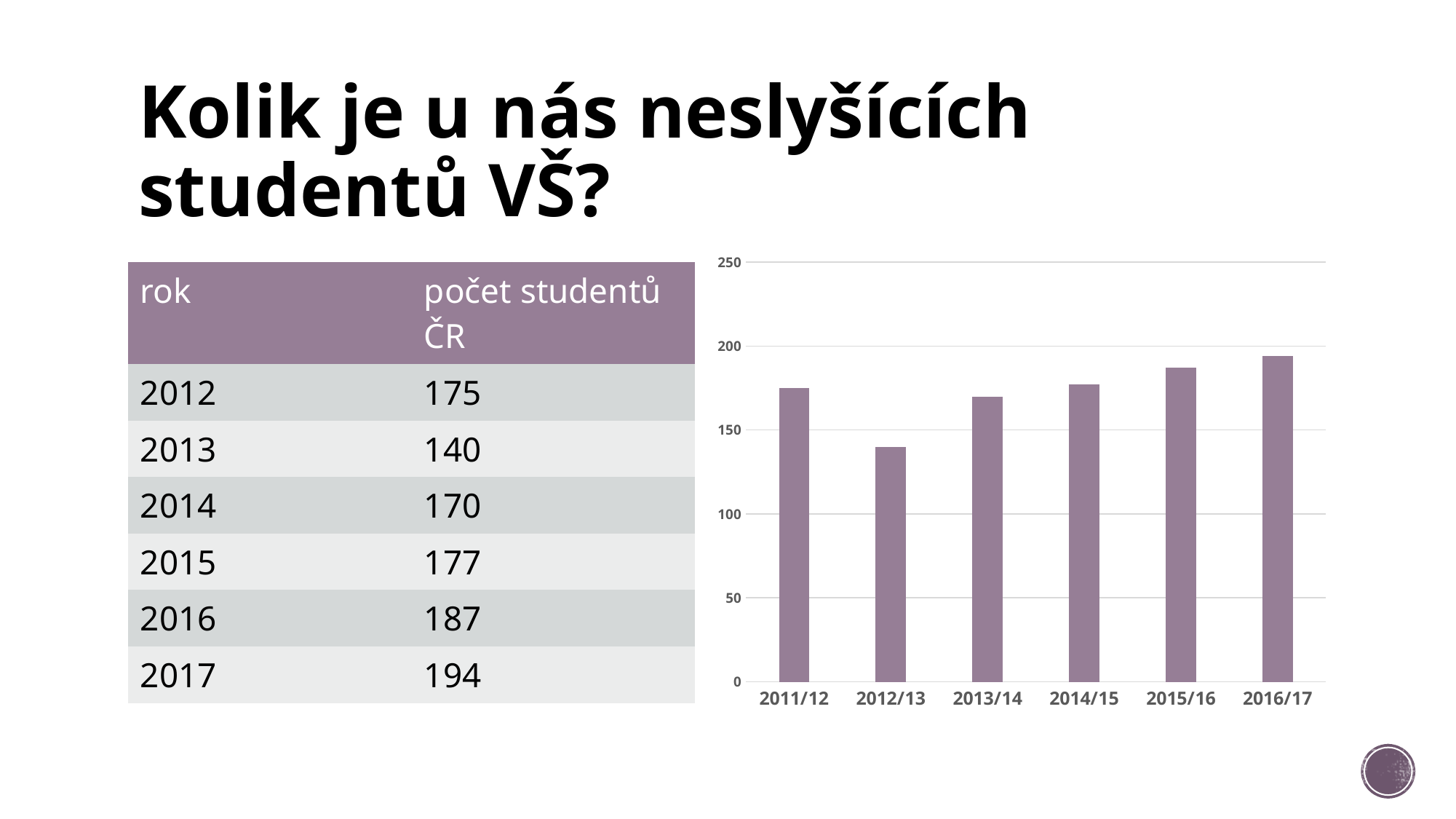
From 2012/13 to 2016/17, do the bar values rise or fall? rise How many bars (academic years) does the chart show? 6 Which is larger, the bar for 2011/12 or the bar for 2012/13? 2011/12 Is the value for 2016/17 greater or less than 200? less What kind of chart is shown on the slide? bar chart Which academic year has the highest bar in the chart? 2016/17 Is the value for 2012/13 greater or less than 150? less What is the highest value shown on the chart's vertical axis? 250 Is the value for 2011/12 greater or less than 150? greater Which academic year has the lowest bar in the chart? 2012/13 Which is larger, the bar for 2015/16 or the bar for 2013/14? 2015/16